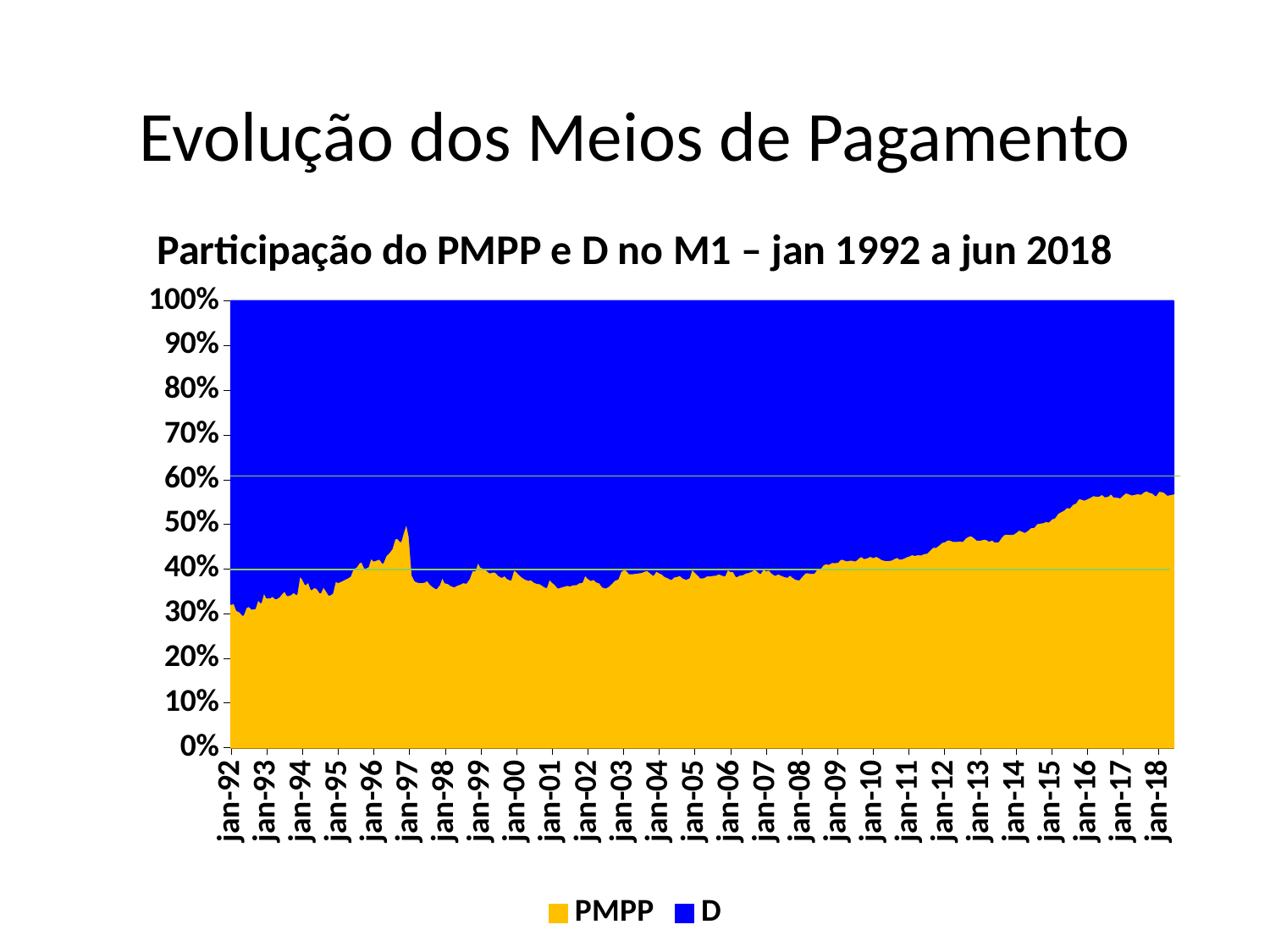
Overall, does the share of PMPP rise or fall from jan-92 to jan-18? rise Is the share of PMPP at jan-18 greater or less than 50%? greater Which series has the larger share at jan-92, PMPP or D? D What kind of chart is shown on the slide? Stacked area chart Is the share of PMPP at jan-92 greater or less than 40%? less Is the share of D at jan-92 greater or less than 60%? greater What is the title of the chart? Participação do PMPP e D no M1 – jan 1992 a jun 2018 Which series has the larger share at jan-18, PMPP or D? PMPP What are the two series named in the legend? PMPP and D How many series does the legend list? 2